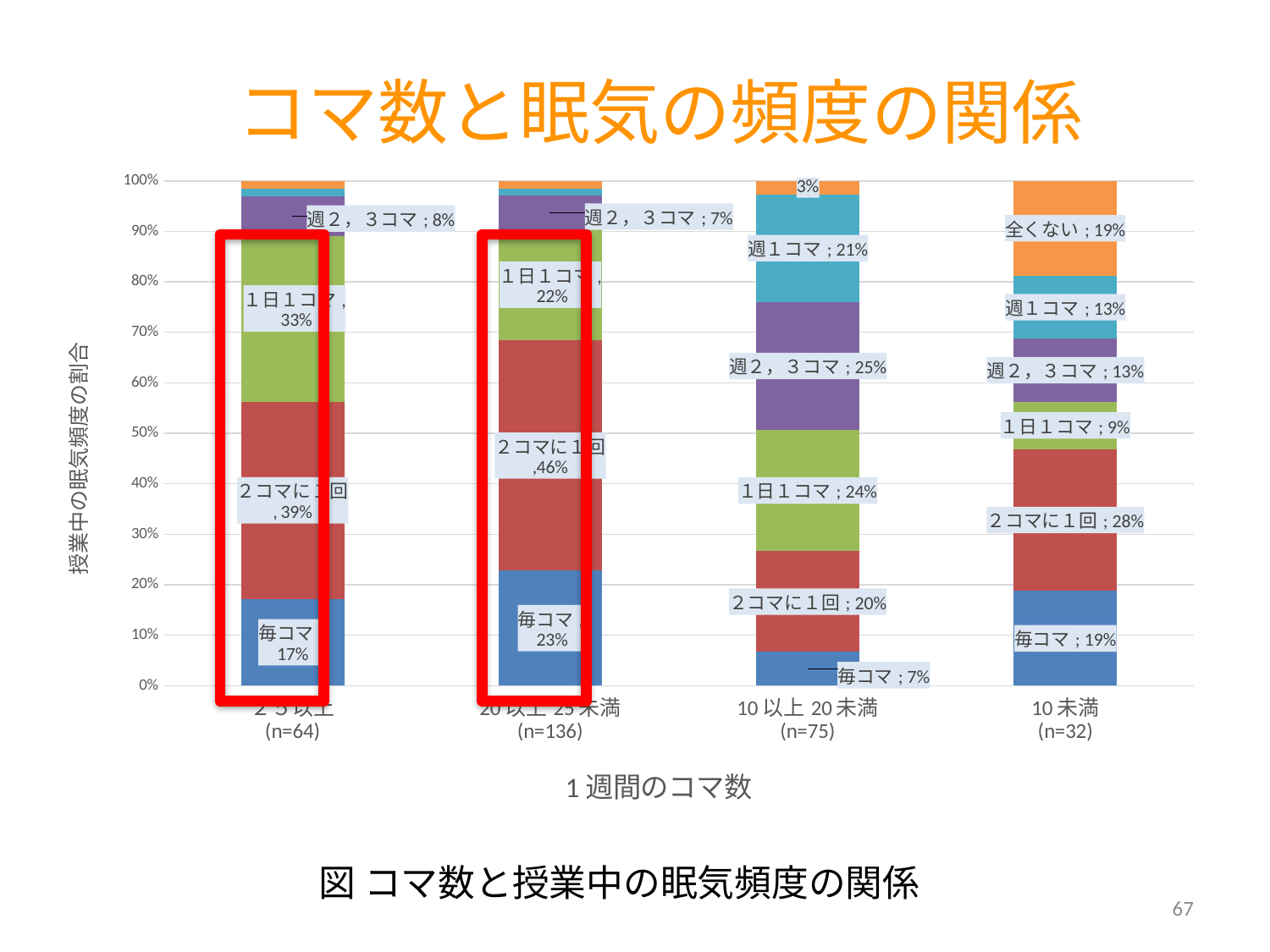
What is the value for 週1コマ in the 10以上20未満 (n=75) group? 21% What is the sample size (n) shown for the 10以上20未満 group? n=75 What is the x-axis title of the chart? 1週間のコマ数 Which group has the lowest value for 毎コマ? 10以上20未満 (n=75) What is the difference between the 2コマに1回 values for the 20以上25未満 group and the 10未満 group? 18% What is the value for 毎コマ in the 25以上 (n=64) group? 17% What is the value for 全くない in the 10未満 (n=32) group? 19% What kind of chart is shown on the slide? Stacked bar chart Which is larger: the 1日1コマ value for the 25以上 group or for the 10以上20未満 group? 25以上 group How many categories (groups of weekly class counts) are shown on the x axis? 4 What is the value for 2コマに1回 in the 20以上25未満 (n=136) group? 46% Which group has the highest value for 毎コマ? 20以上25未満 (n=136)